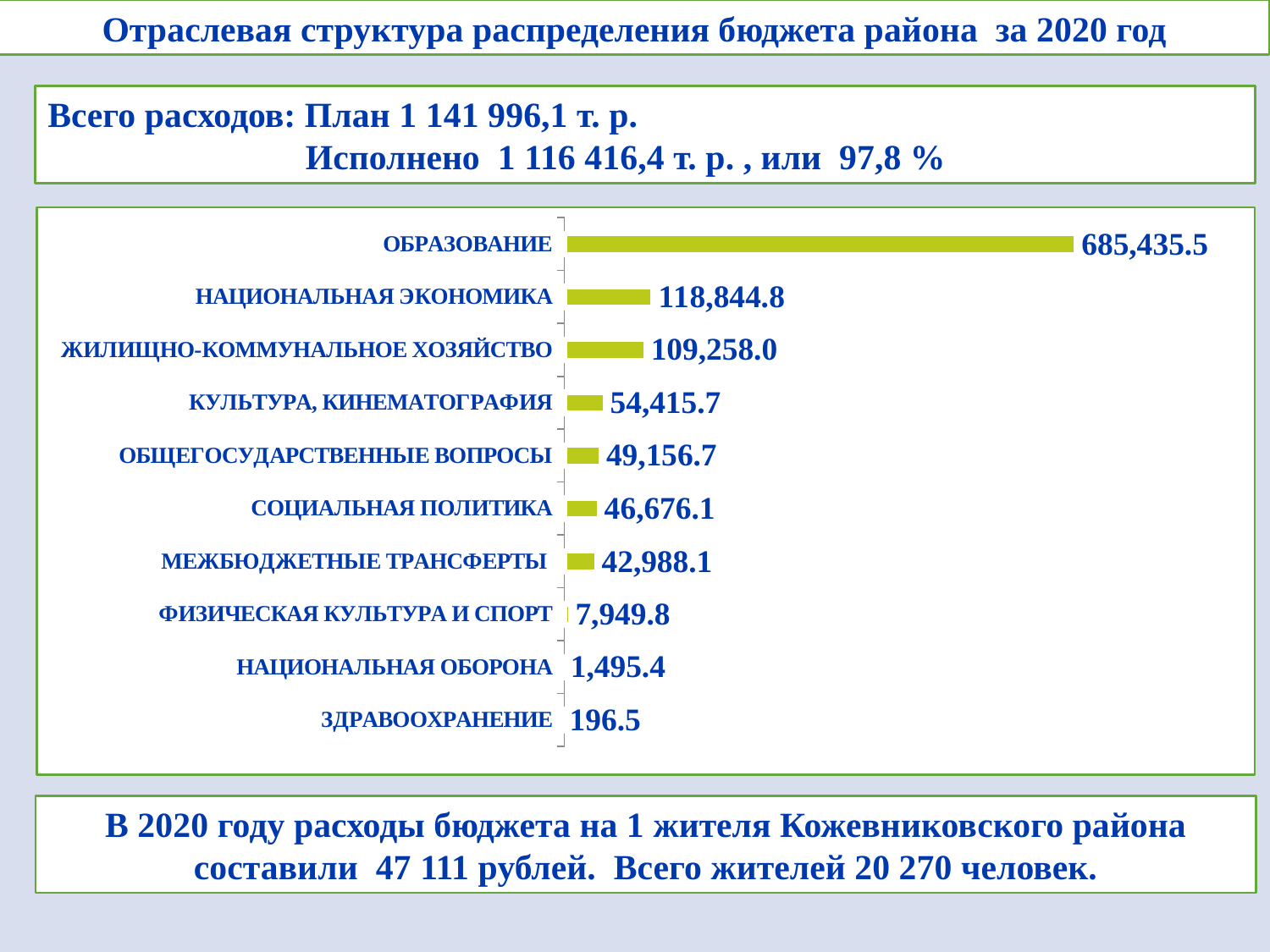
What is the value for ОБРАЗОВАНИЕ? 685,435.5 Which category has the highest value? ОБРАЗОВАНИЕ What kind of chart is shown on the slide? Bar chart Which category has the lowest value? ЗДРАВООХРАНЕНИЕ What is the value for МЕЖБЮДЖЕТНЫЕ ТРАНСФЕРТЫ? 42,988.1 What is the difference between the values for НАЦИОНАЛЬНАЯ ЭКОНОМИКА and ЖИЛИЩНО-КОММУНАЛЬНОЕ ХОЗЯЙСТВО? 9,586.8 How many categories are shown in the chart? 10 What is the value for ЖИЛИЩНО-КОММУНАЛЬНОЕ ХОЗЯЙСТВО? 109,258.0 What is the value for НАЦИОНАЛЬНАЯ ОБОРОНА? 1,495.4 Which is larger, the value for СОЦИАЛЬНАЯ ПОЛИТИКА or the value for МЕЖБЮДЖЕТНЫЕ ТРАНСФЕРТЫ? СОЦИАЛЬНАЯ ПОЛИТИКА Which is larger, the value for ФИЗИЧЕСКАЯ КУЛЬТУРА И СПОРТ or the value for НАЦИОНАЛЬНАЯ ОБОРОНА? ФИЗИЧЕСКАЯ КУЛЬТУРА И СПОРТ What is the difference between the values for КУЛЬТУРА, КИНЕМАТОГРАФИЯ and ОБЩЕГОСУДАРСТВЕННЫЕ ВОПРОСЫ? 5,259.0